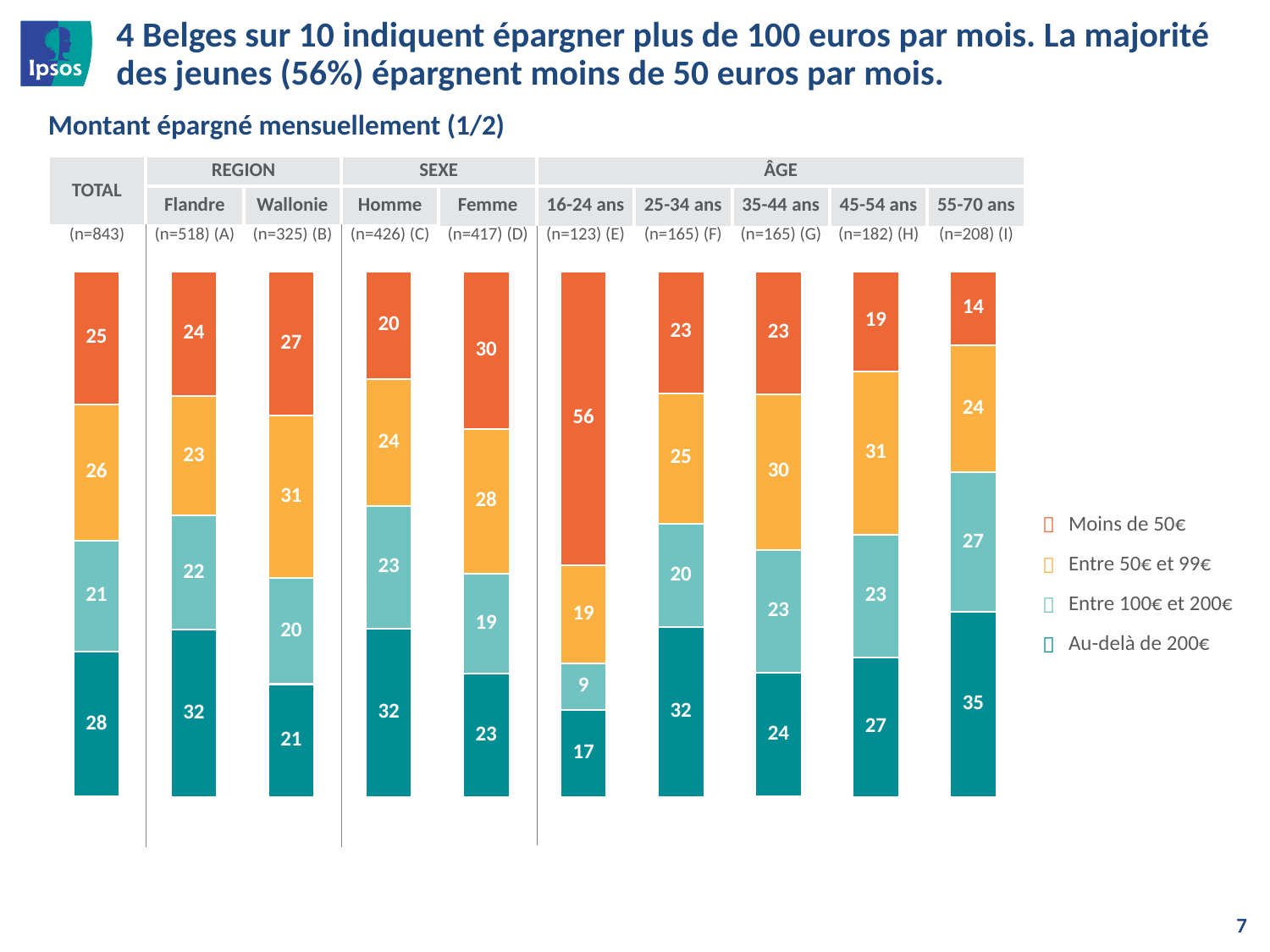
Which is larger, the 'Au-delà de 200€' value for Flandre or for Wallonie? Flandre What is the value of the 'Entre 50€ et 99€' segment for Wallonie? 31 What is the total of the stacked bar for the 35-44 ans group? 100 What is the difference between the 'Moins de 50€' values for Femme and Homme? 10 Which group has the highest value for the 'Au-delà de 200€' segment? 55-70 ans What kind of chart is shown on the slide? Stacked bar chart What is the value of the 'Au-delà de 200€' segment for the TOTAL bar? 28 What is the value of the 'Moins de 50€' segment for the 16-24 ans group? 56 How many bars (groups) are shown in the chart? 10 What is the value of the 'Entre 100€ et 200€' segment for Femme? 19 How many series does the legend list? 4 Which group has the lowest value for the 'Moins de 50€' segment? 55-70 ans